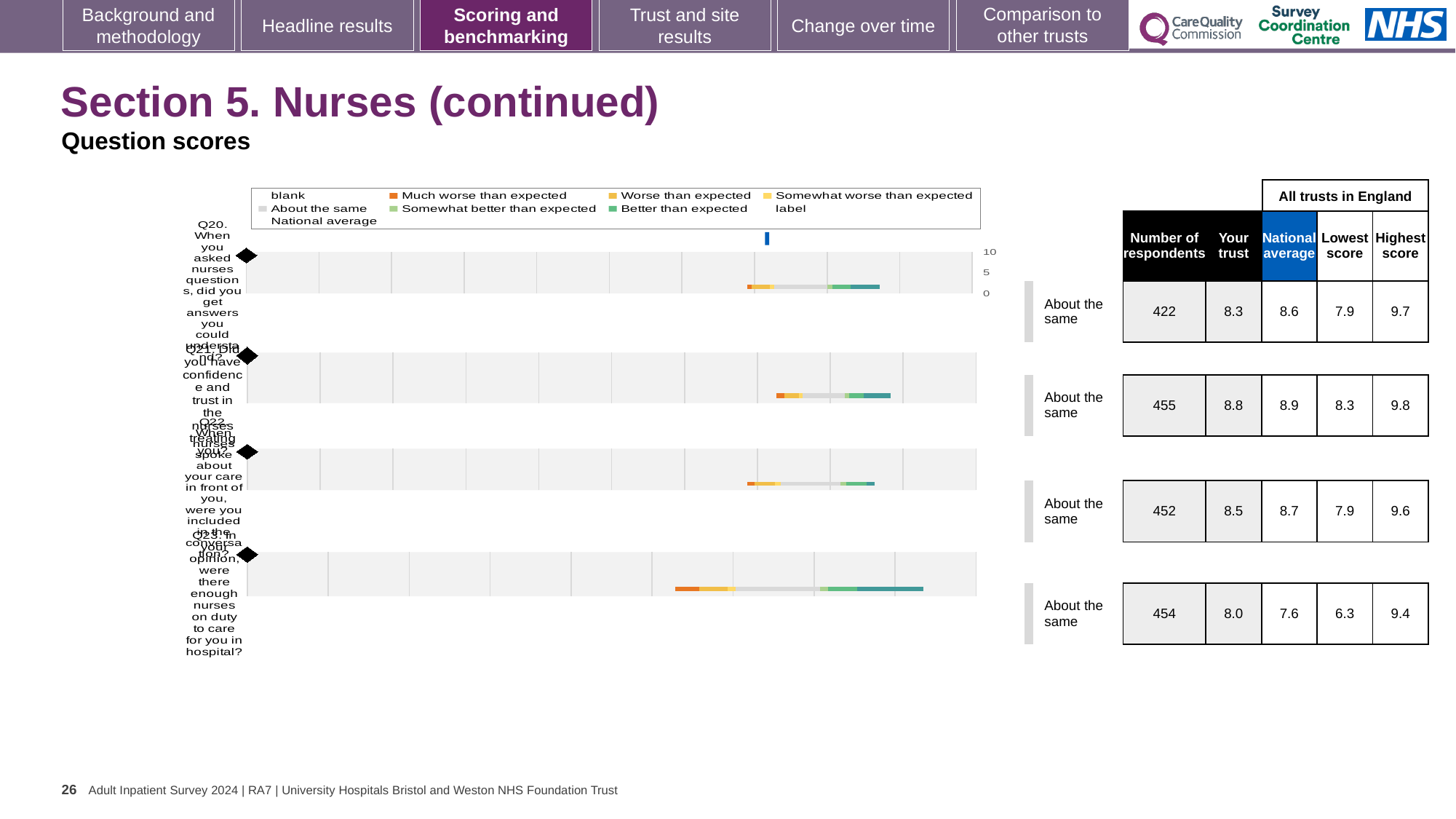
In the table beside the charts, what is the highest score among all trusts in England for Q20? 9.7 How many question charts (Q20 to Q23) are shown on the slide? 4 What benchmark category is shown for Q20 (answers you could understand)? About the same In the table beside the charts, how many respondents answered Q22 (nurses spoke about your care in front of you)? 452 In the table beside the charts, what is the lowest score among all trusts in England for Q21? 8.3 In the table beside the charts, what is the national average for Q23 (enough nurses on duty)? 7.6 In the table beside the charts, what is the 'Your trust' score for Q21 (confidence and trust in the nurses)? 8.8 For Q23, what is the difference between the 'Your trust' score and the national average in the table? 0.4 What kind of chart is used to show the question scores for Q20 to Q23? bar chart Which question (Q20 to Q23) has the highest 'Your trust' score in the table? Q21 Which question (Q20 to Q23) has the lowest 'Lowest score' among all trusts in England in the table? Q23 For Q20, which is larger in the table: the 'Your trust' score or the national average? National average